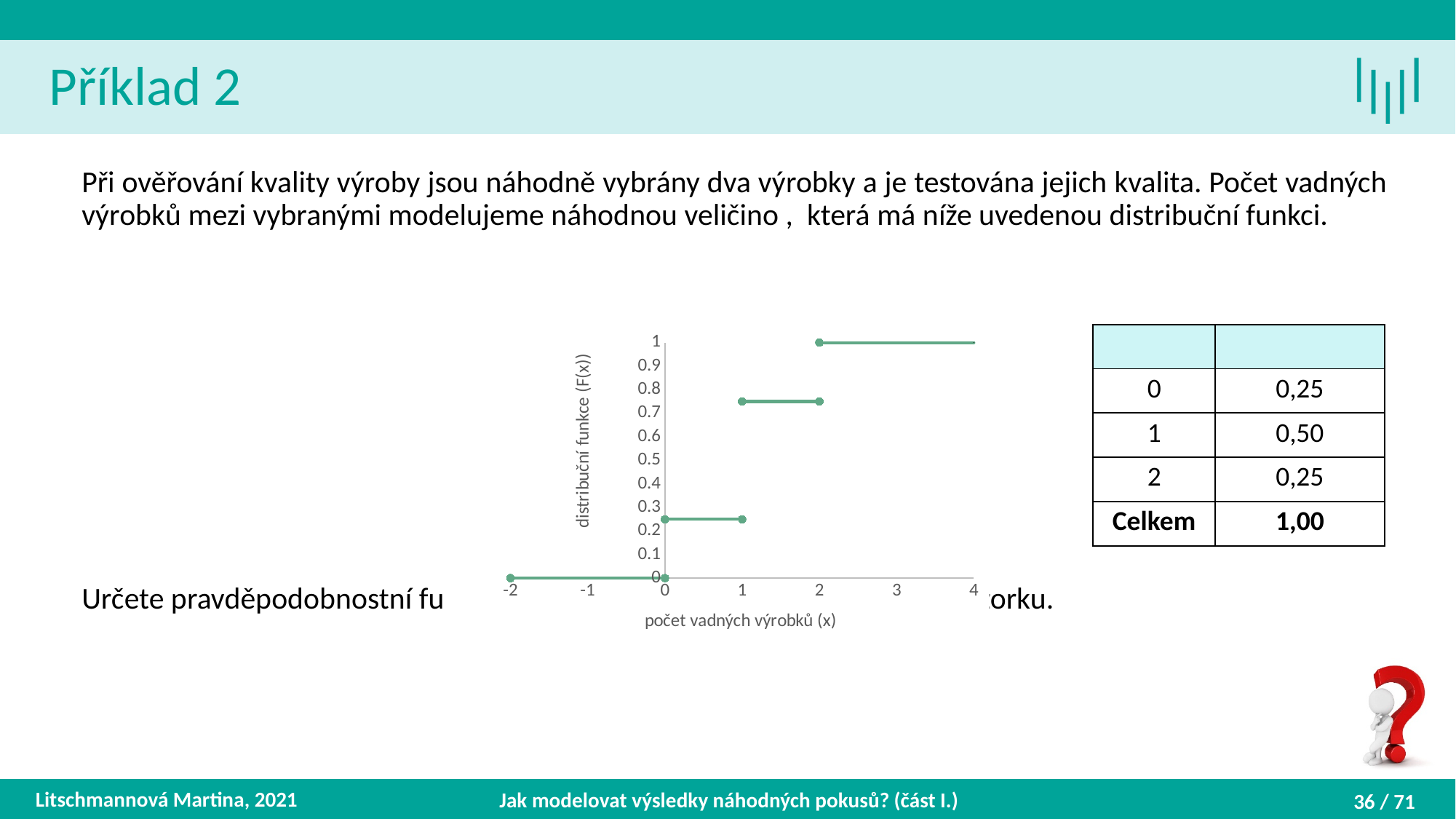
Is the value of the distribution function for x between 1 and 2 greater or less than 0.8? less Do the plotted values rise or fall as x increases along the x axis? rise What value does the distribution function take for x between -2 and 0? 0 What kind of chart is shown on the slide? line chart (step function) What value does the distribution function take for x from 2 to 4? 1 Is the value of the distribution function for x between 0 and 1 greater or less than 0.2? greater How many horizontal step segments are plotted in the chart? 4 Which is larger: the value of the function for x between 1 and 2, or for x between 0 and 1? x between 1 and 2 Is the value of the distribution function for x between 1 and 2 greater or less than 0.7? greater What is the title of the x axis of the chart? počet vadných výrobků (x) What is the title of the y axis of the chart? distribuční funkce (F(x))